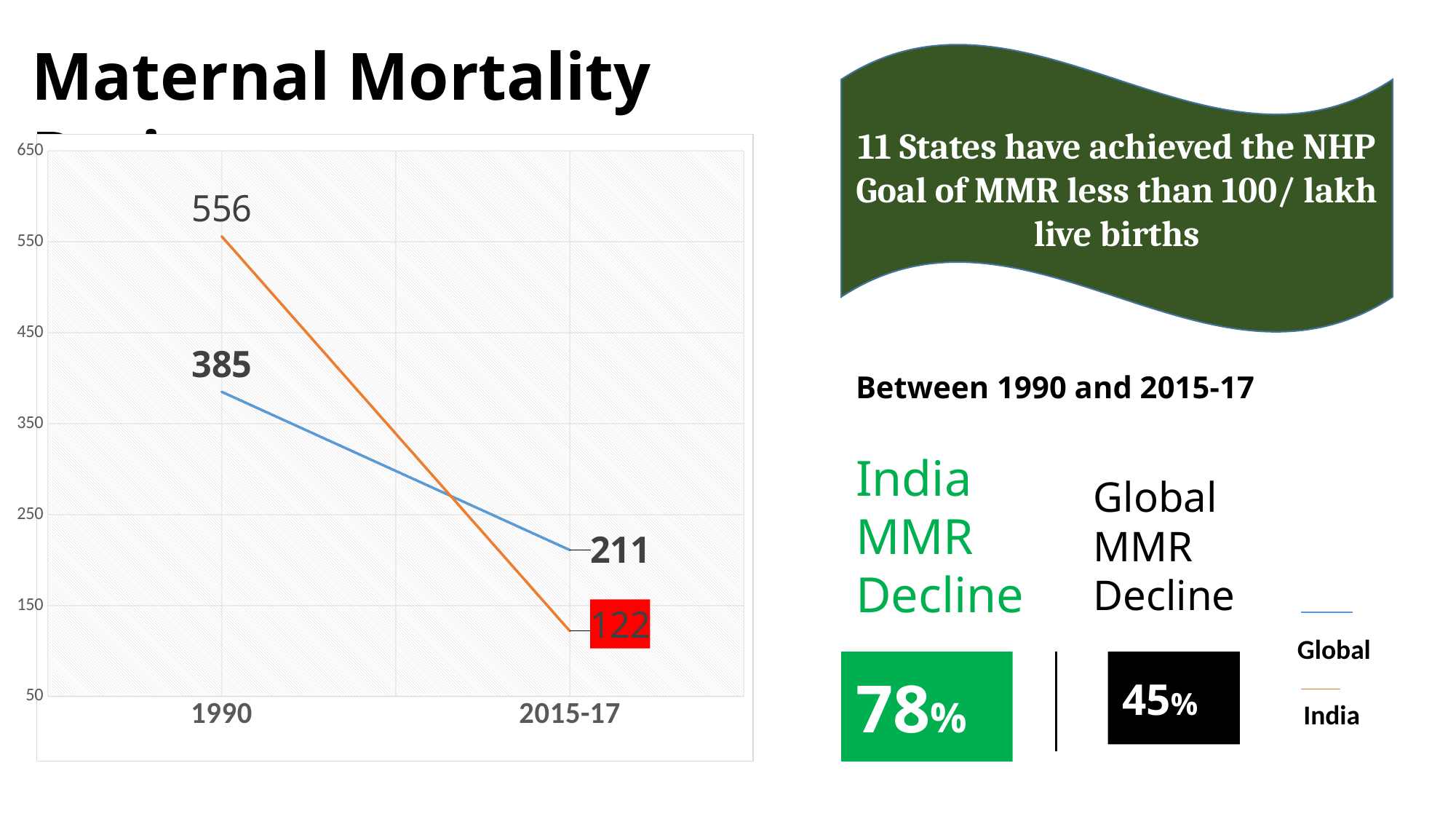
How many points are plotted on the x axis? 2 Which colour is used for the India line? orange By how much did the India value decrease from 1990 to 2015-17? 434 Does the India line rise or fall from 1990 to 2015-17? fall How many series does the legend list? 2 What is the difference between the Global and India values in 2015-17? 89 What is the value for India in 1990? 556 What is the value for Global in 2015-17? 211 What is the value for Global in 1990? 385 What type of chart is shown on the slide? line chart What is the value for India in 2015-17? 122 Which series has the higher value in 1990, India or Global? India